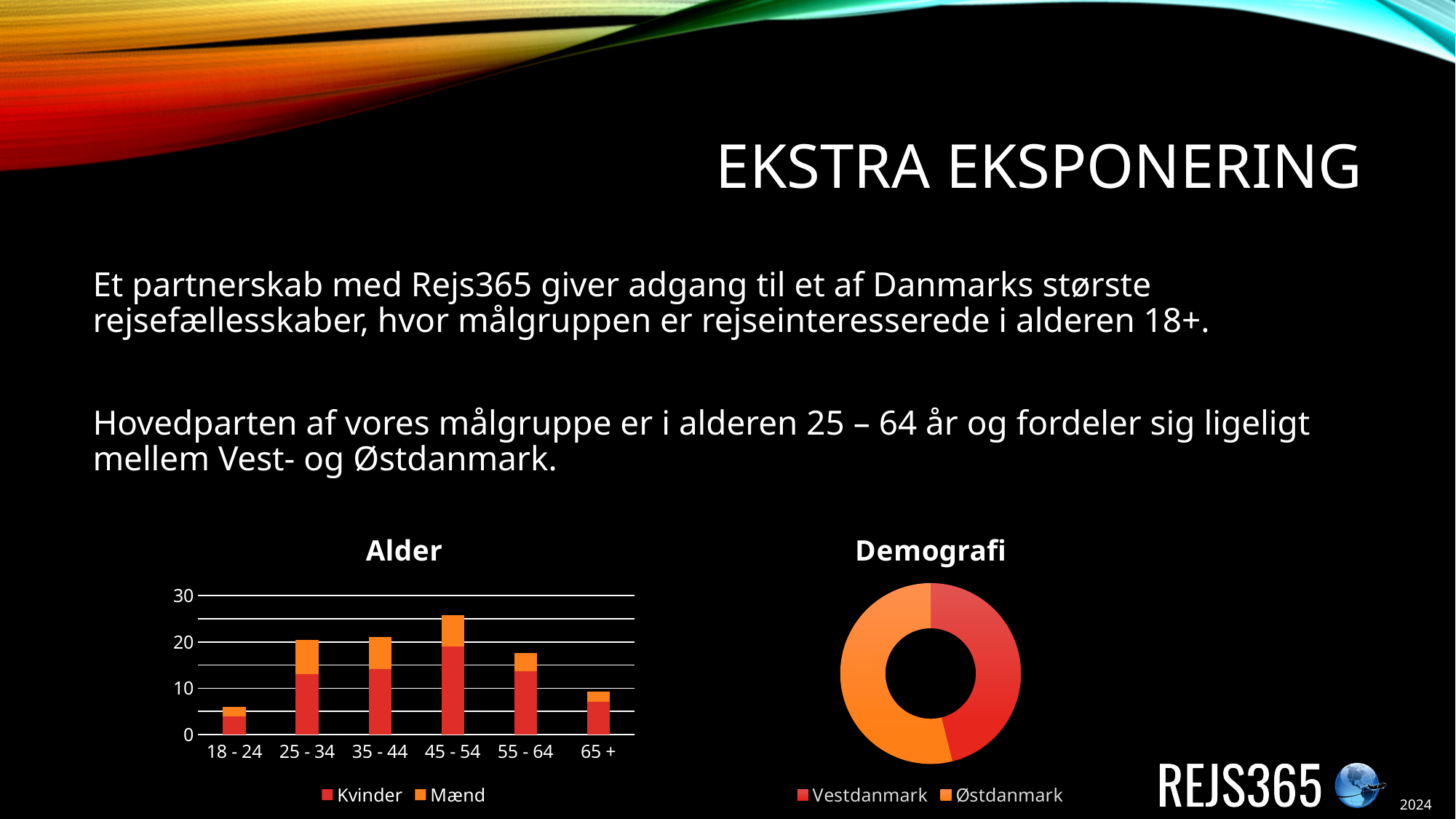
How many age categories are shown on the x axis of the 'Alder' chart? 6 What kind of chart is the 'Demografi' chart? doughnut chart In the 'Alder' chart, is the total for 55 - 64 greater or less than 20? less In the 'Alder' chart, which stacked bar is taller: 45 - 54 or 65 +? 45 - 54 In the 'Alder' chart, which age group has the tallest stacked bar? 45 - 54 How many categories does the legend of the 'Demografi' chart list? 2 In the 'Demografi' chart, which colour represents Vestdanmark? red How many series does the legend of the 'Alder' chart list? 2 In the 'Alder' chart, is the total for 18 - 24 greater or less than 10? less What kind of chart is the 'Alder' chart? bar chart In the 'Alder' chart, which age group has the shortest stacked bar? 18 - 24 In the 'Alder' chart, is the total for 45 - 54 greater or less than 20? greater